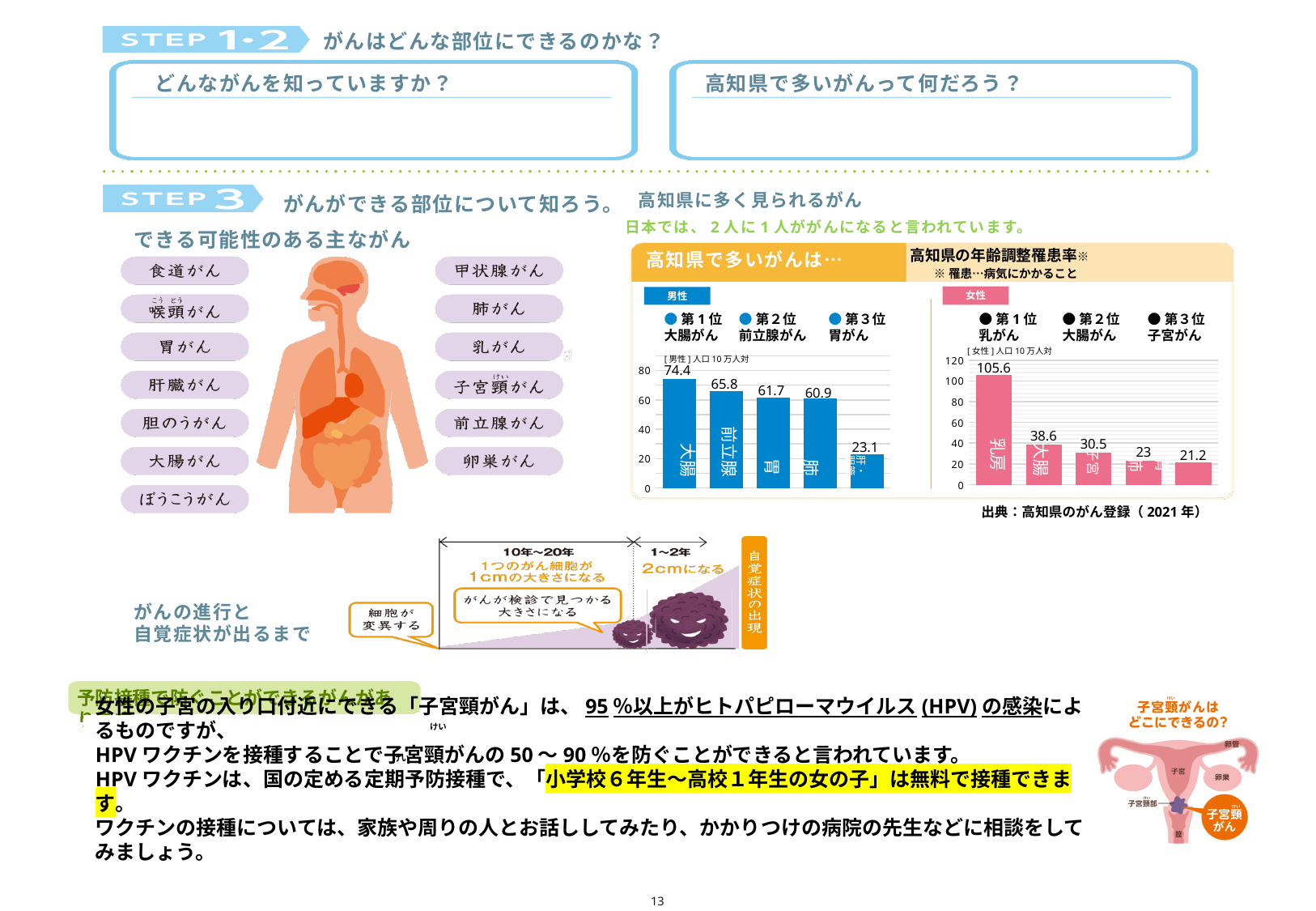
In the 女性 (female) chart, what is the value for 大腸? 38.6 In the 女性 (female) chart, what is the difference between the values for 乳房 and 大腸? 67 In the 男性 (male) chart, what is the difference between the values for 大腸 and 前立腺? 8.6 In the 男性 (male) chart, what is the value for 前立腺? 65.8 In the 女性 (female) chart, what is the value for 子宮? 30.5 In the 男性 (male) chart, which is larger, the value for 胃 or the value for 肺? 胃 In the 男性 (male) chart, which category has the highest value? 大腸 What type of chart is used to show the 高知県の年齢調整罹患率 data? bar chart In the 女性 (female) chart, what is the value for 乳房? 105.6 In the 男性 (male) chart, what is the value for 大腸? 74.4 How many bars are plotted in the 男性 (male) chart? 5 In the 女性 (female) chart, is the value for 乳房 greater or less than 100? greater